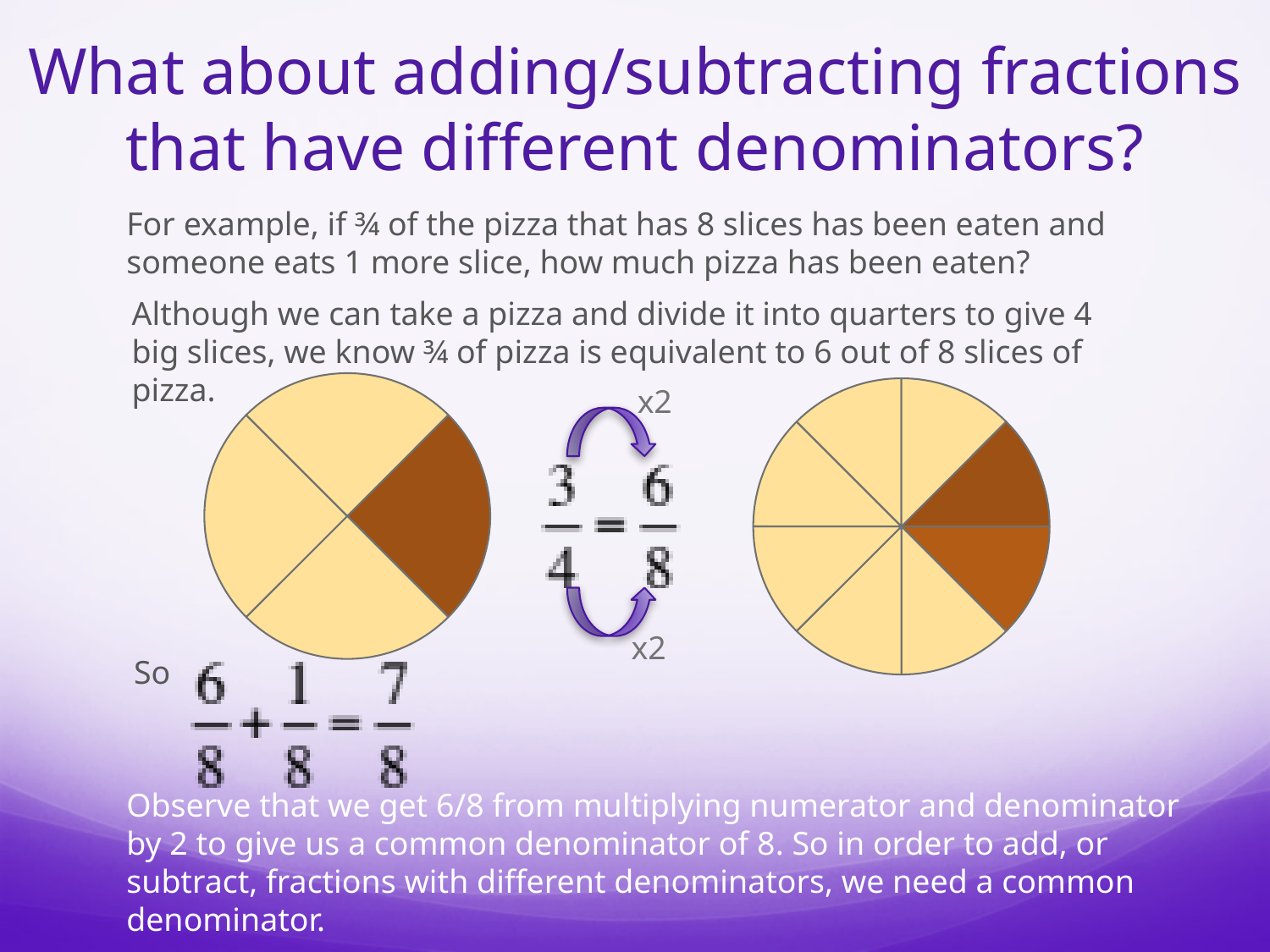
How many slices of the right pizza are shaded brown? 2 What multiplier is written next to the arrows between the fractions 3/4 and 6/8? x2 How many slices of the left pizza are shaded brown? 1 How many slices is the pizza on the left divided into? 4 What kind of chart are the two pizza diagrams? pie chart Which pizza diagram has more slices, the left one or the right one? the right one What fraction is shown as equivalent to 3/4 between the two pizza diagrams? 6/8 What is the difference in the number of slices between the right pizza and the left pizza? 4